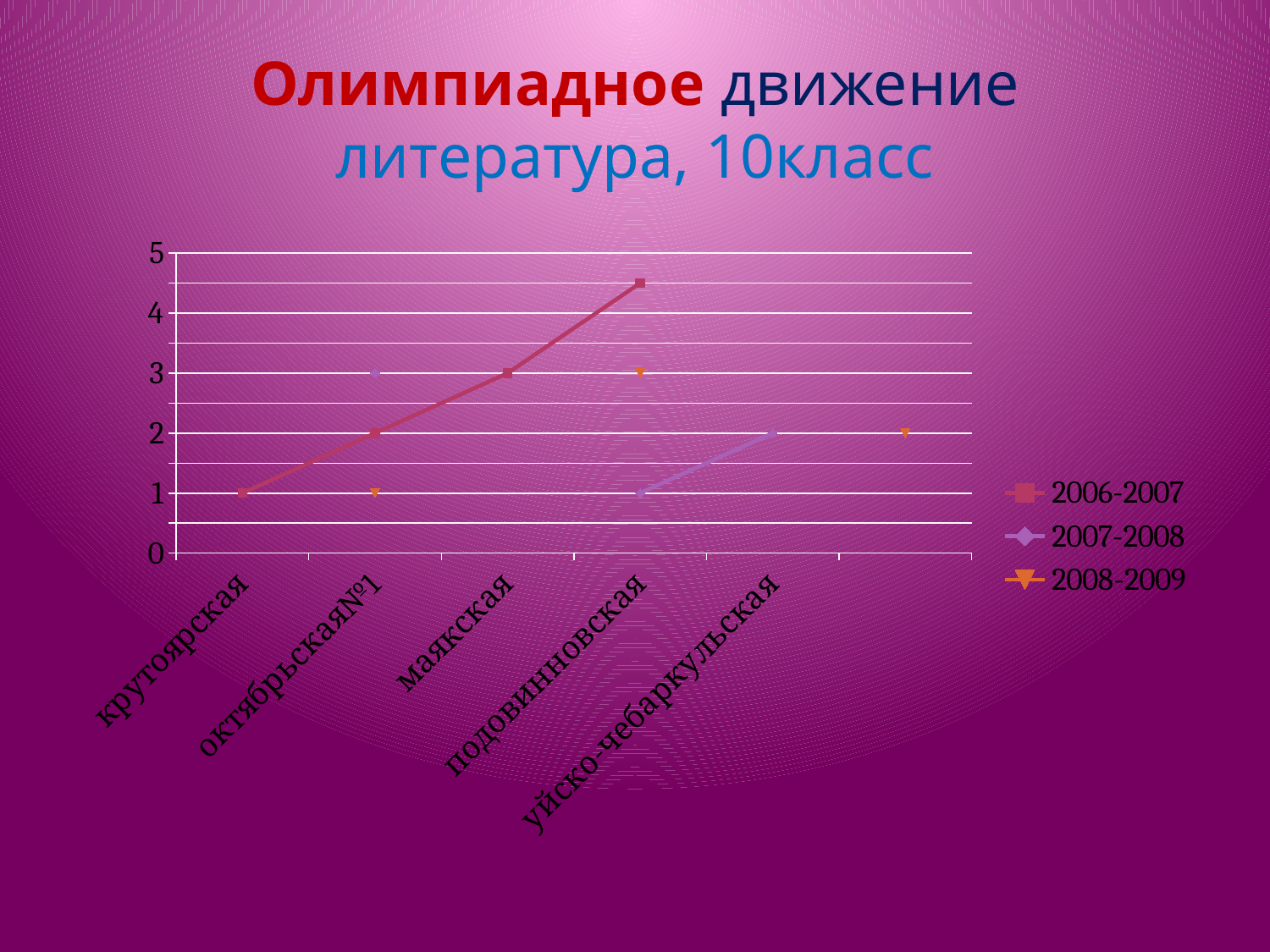
How many series does the legend list? 3 What is the value for крутоярская in the 2006-2007 series? 1 In the 2007-2008 series, what is the difference between the values for уйско-чебаркульская and подовинновская? 1 What is the value for октябрьская№1 in the 2007-2008 series? 3 Which series is shown with orange triangle markers in the legend? 2008-2009 What is the value for маякская in the 2006-2007 series? 3 What is the value for подовинновская in the 2008-2009 series? 3 Which category has the highest value in the 2006-2007 series? подовинновская Does the 2006-2007 series rise or fall from крутоярская to подовинновская? rise Is the value for подовинновская in the 2006-2007 series greater or less than 4? greater At октябрьская№1, which series has the larger value, 2007-2008 or 2008-2009? 2007-2008 What kind of chart is shown on the slide? line chart